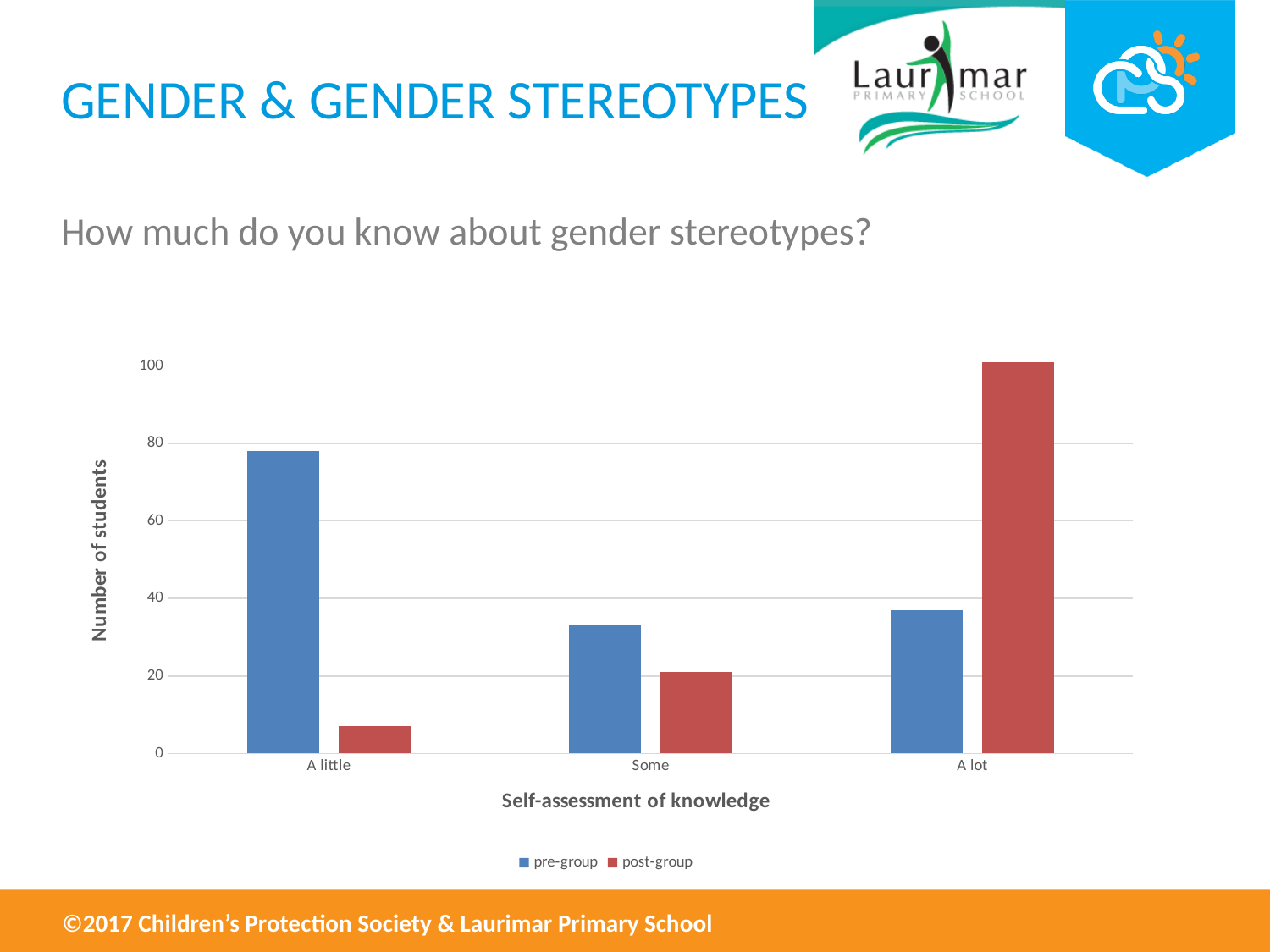
Is the pre-group value for A little greater or less than 60? greater What kind of chart is shown on the slide? bar chart Is the post-group value for A little greater or less than 20? less How many series does the legend list? 2 Is the post-group value for A lot greater or less than 80? greater How many categories are shown on the x axis? 3 For the A lot category, which is larger: the pre-group value or the post-group value? post-group Which category has the highest post-group value? A lot Which category has the lowest post-group value? A little What is the label of the y axis? Number of students Which category has the highest pre-group value? A little